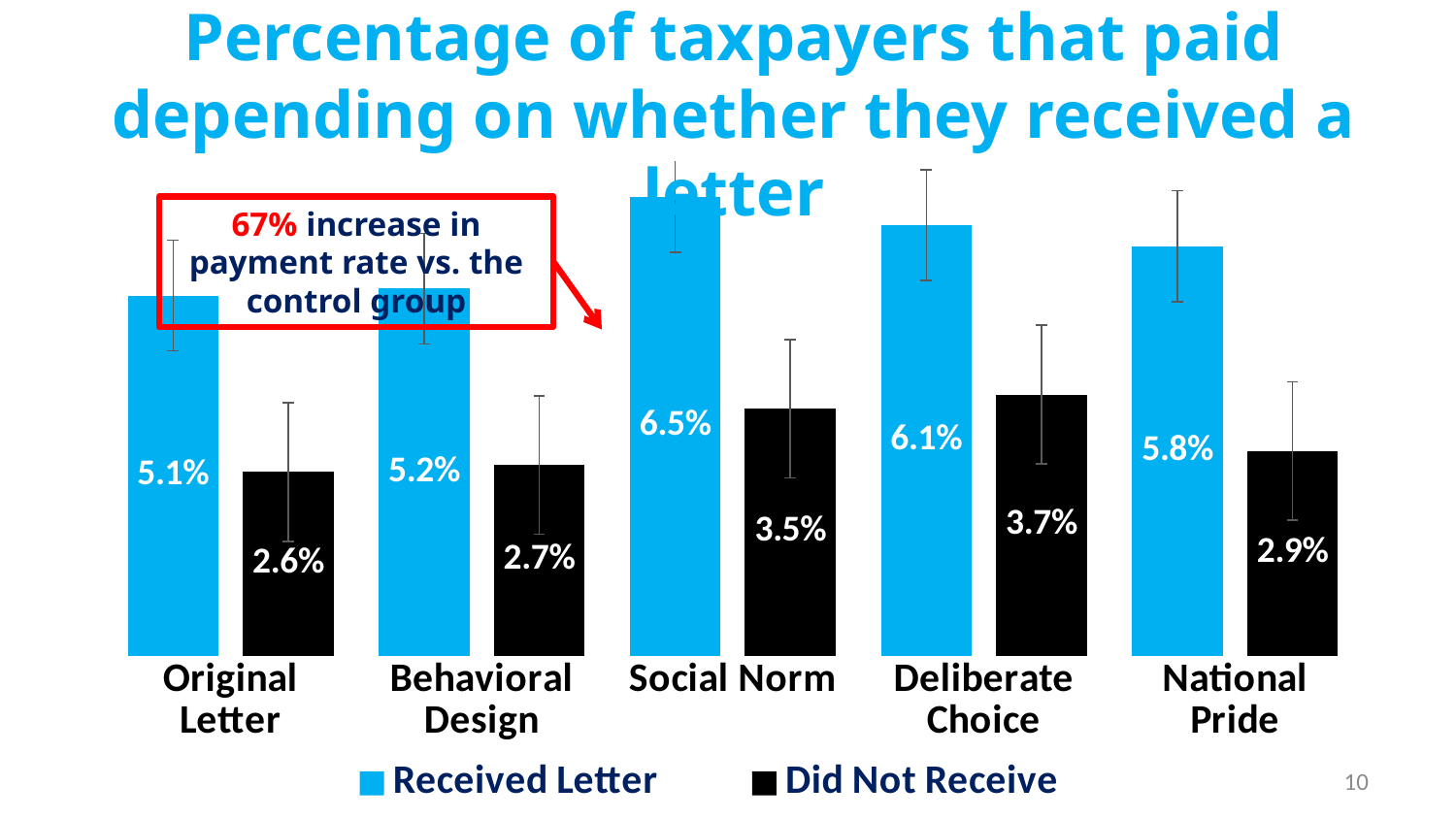
How many letter types are shown on the x axis? 5 Which colour represents the Did Not Receive series? Black Which letter type has the highest Received Letter payment rate? Social Norm What is the difference between the Received Letter and Did Not Receive values for Behavioral Design? 2.5% How many series does the legend list? 2 What kind of chart is shown on the slide? Bar chart Which group has the lowest Did Not Receive payment rate? Original Letter Which is larger: the Received Letter value for Deliberate Choice or for National Pride? Deliberate Choice What percentage of taxpayers who received the Social Norm letter paid? 6.5% What is the Did Not Receive value for the Deliberate Choice group? 3.7% What is the difference between the Received Letter values for Social Norm and Original Letter? 1.4% What is the Received Letter value for National Pride? 5.8%